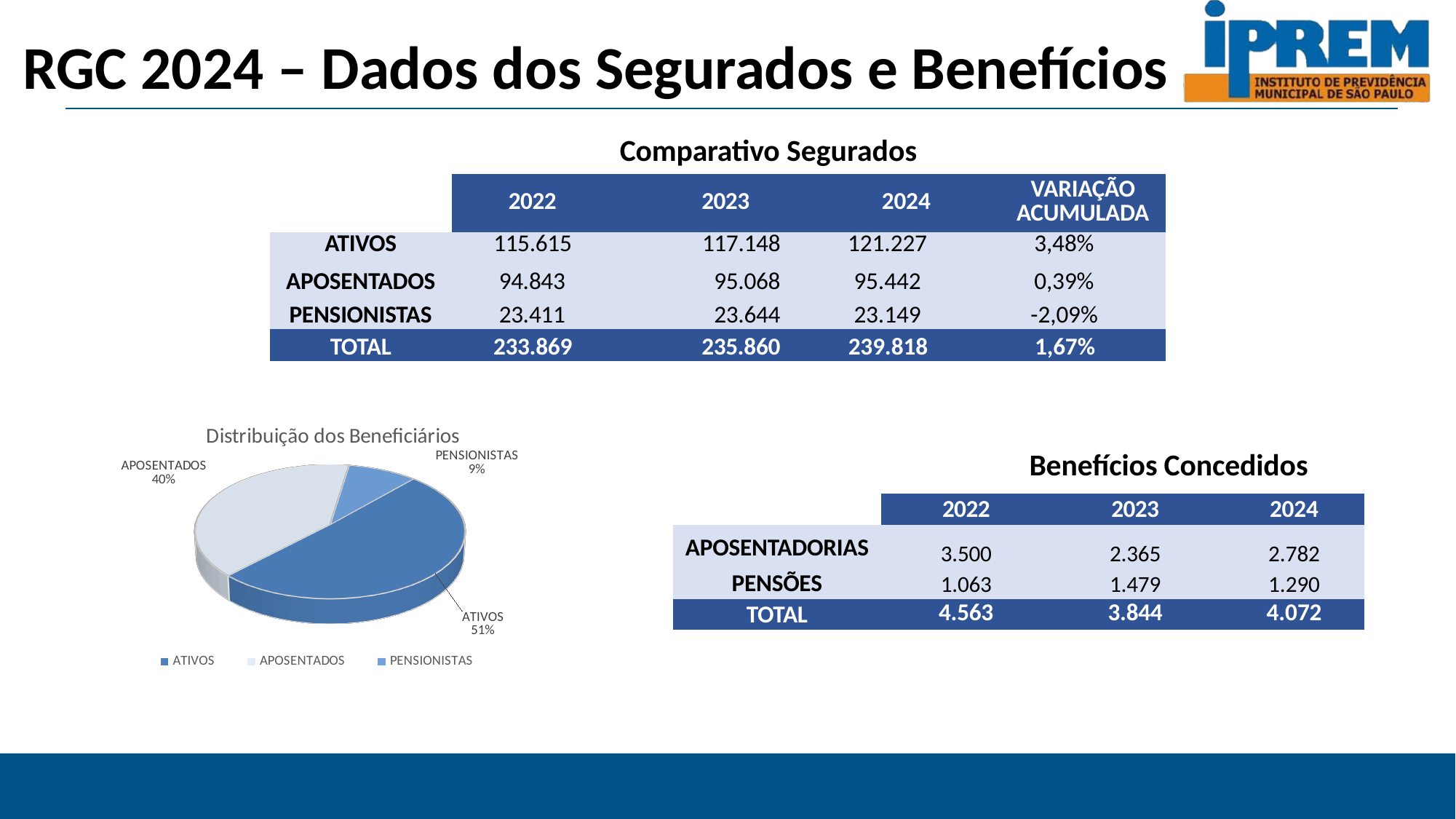
What is the title of the pie chart on the slide? Distribuição dos Beneficiários How many entries does the legend of the 'Distribuição dos Beneficiários' pie chart list? 3 In the 'Distribuição dos Beneficiários' pie chart, which category has the largest slice? ATIVOS In the 'Distribuição dos Beneficiários' pie chart, how many slices are there? 3 In the 'Distribuição dos Beneficiários' pie chart, what is the difference in percentage points between ATIVOS and APOSENTADOS? 11 In the 'Distribuição dos Beneficiários' pie chart, which category has the smallest slice? PENSIONISTAS In the 'Distribuição dos Beneficiários' pie chart, what share does ATIVOS have? 51% In the 'Distribuição dos Beneficiários' pie chart, what share does PENSIONISTAS have? 9% In the 'Distribuição dos Beneficiários' pie chart, what is the difference in percentage points between APOSENTADOS and PENSIONISTAS? 31 In the 'Distribuição dos Beneficiários' pie chart, which is larger, APOSENTADOS or PENSIONISTAS? APOSENTADOS In the 'Distribuição dos Beneficiários' pie chart, what share does APOSENTADOS have? 40% What kind of chart is 'Distribuição dos Beneficiários'? Pie chart